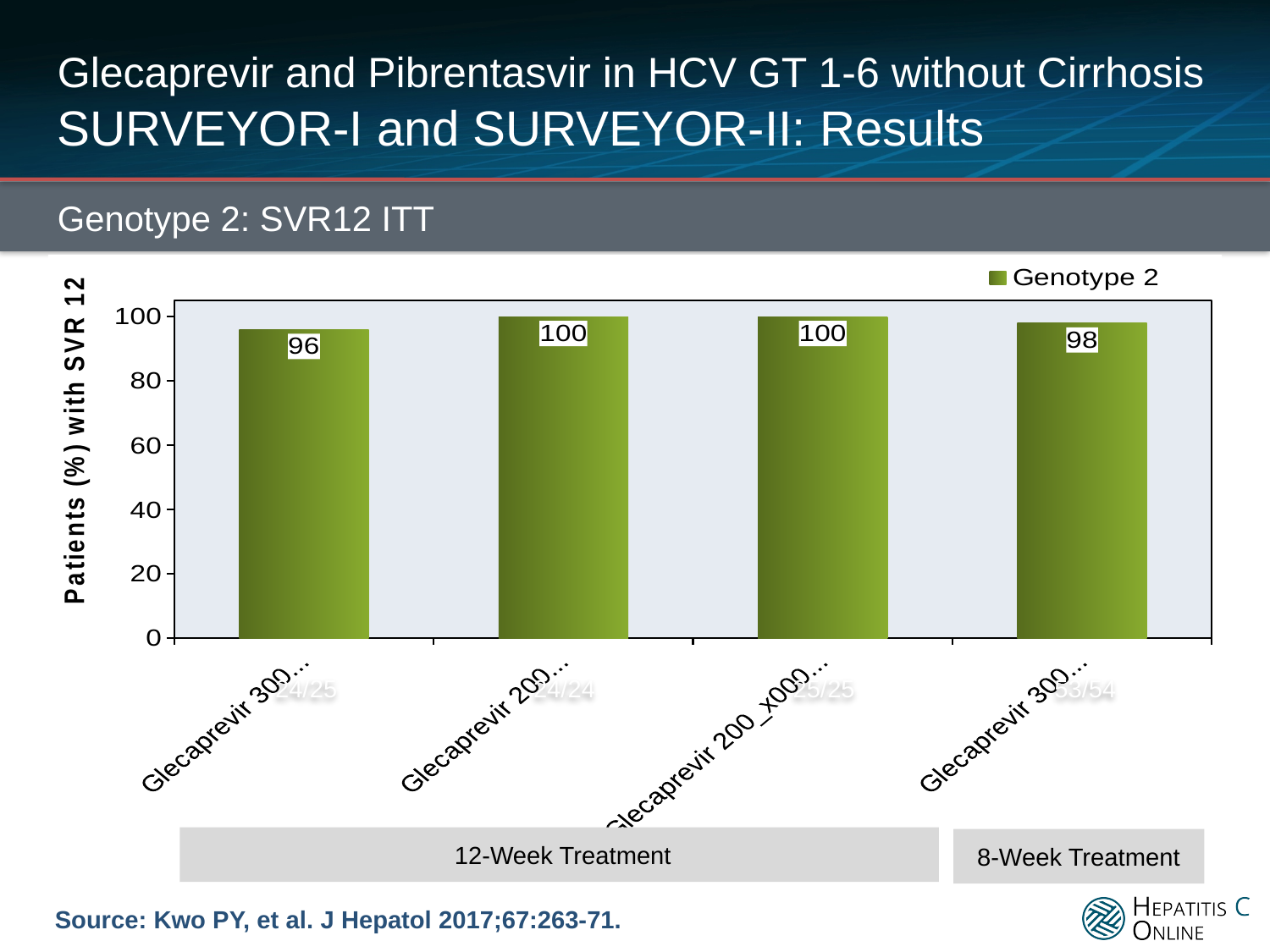
What is the value shown on the leftmost bar of the chart? 96 What is the difference between the 8-Week Treatment bar and the leftmost bar? 2 How many bars are plotted in the chart? 4 What is the highest value shown on any bar in the chart? 100 What is the SVR12 value for the bar in the 8-Week Treatment group? 98 Which is larger: the leftmost bar or the 8-Week Treatment bar? The 8-Week Treatment bar What is the value shown on the second bar from the left? 100 Which bar has the lowest value in the chart? The leftmost bar (96) Is the value of the leftmost bar greater or less than 80? greater What type of chart is shown on the slide? Bar chart How many series does the legend list? 1 How many bars belong to the 12-Week Treatment group? 3